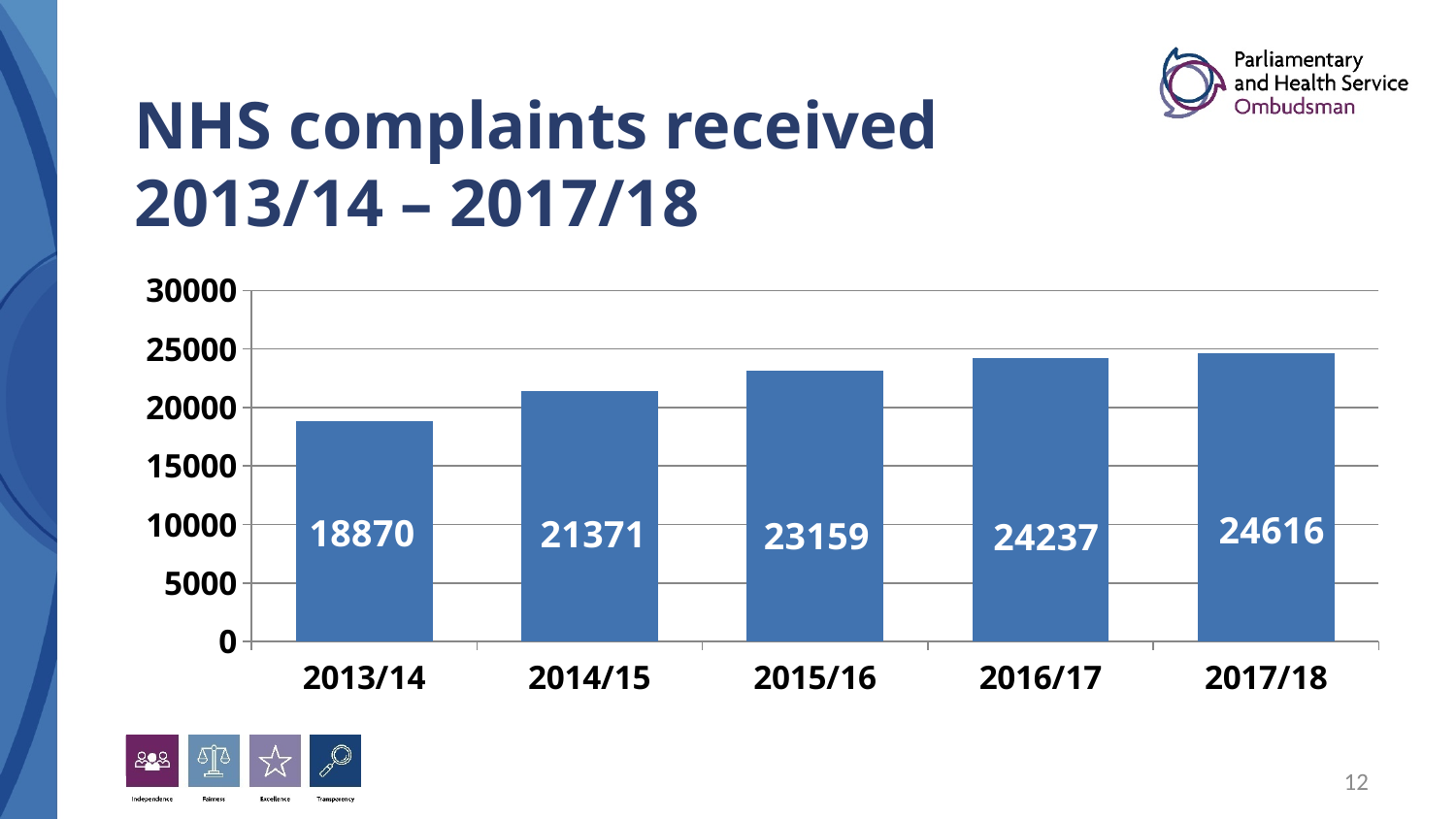
Which year has the lowest number of complaints received? 2013/14 How many NHS complaints were received in 2013/14? 18870 How many complaints were received in 2017/18? 24616 By how much did complaints increase from 2014/15 to 2015/16? 1788 Is the value for 2013/14 greater or less than 20000? less Which year had more complaints, 2014/15 or 2016/17? 2016/17 Which year has the highest number of complaints received? 2017/18 What kind of chart is shown on the slide? Bar chart Do the values rise or fall from 2013/14 to 2017/18? Rise What is the difference between the complaints received in 2017/18 and 2013/14? 5746 What is the value shown for 2015/16? 23159 How many years are shown on the x axis? 5